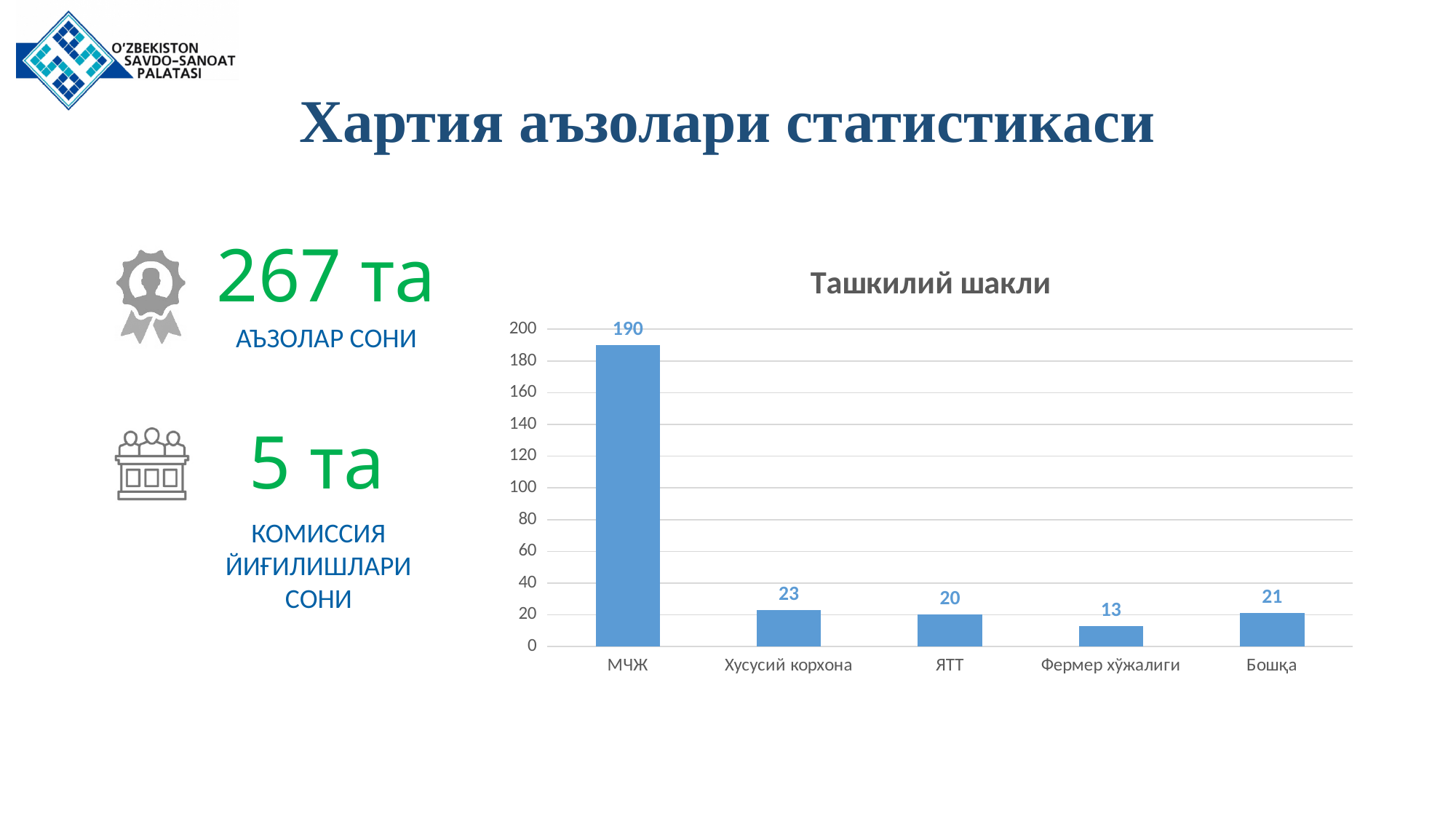
Which is larger, the value for Хусусий корхона or the value for ЯТТ? Хусусий корхона Which category has the highest value? МЧЖ What is the value for Фермер хўжалиги? 13 What is the value for Бошқа? 21 What is the difference between the values for Бошқа and ЯТТ? 1 What is the value for МЧЖ in the chart? 190 Is the value for МЧЖ greater or less than 180? greater What is the value for Хусусий корхона? 23 Which category has the lowest value? Фермер хўжалиги What is the title of the chart? Ташкилий шакли What is the difference between the values for МЧЖ and Хусусий корхона? 167 How many categories are shown on the x axis of the chart? 5